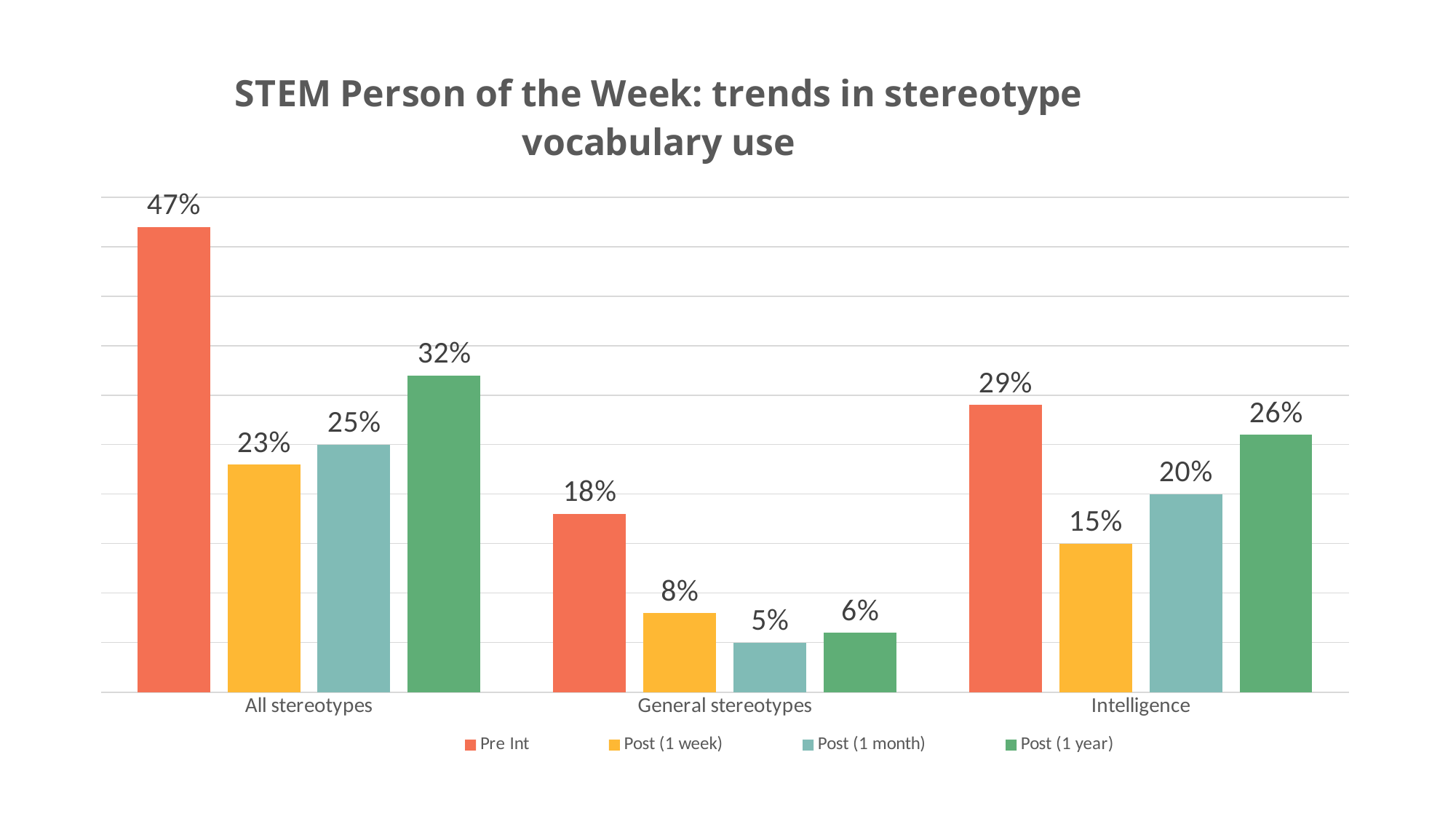
What is the Post (1 year) value for Intelligence? 26% How many series does the legend list? 4 How many categories are shown on the x axis? 3 What is the Post (1 week) value for Intelligence? 15% What is the difference between the Post (1 year) and Post (1 month) values for Intelligence? 6% What is the difference between the Pre Int and Post (1 week) values for All stereotypes? 24% Which is larger for General stereotypes: the Post (1 week) value or the Post (1 year) value? Post (1 week) Which category has the lowest Post (1 year) value? General stereotypes What is the Post (1 month) value for General stereotypes? 5% What kind of chart is shown on the slide? Bar chart What is the Pre Int value for All stereotypes? 47% Which category has the highest Pre Int value? All stereotypes